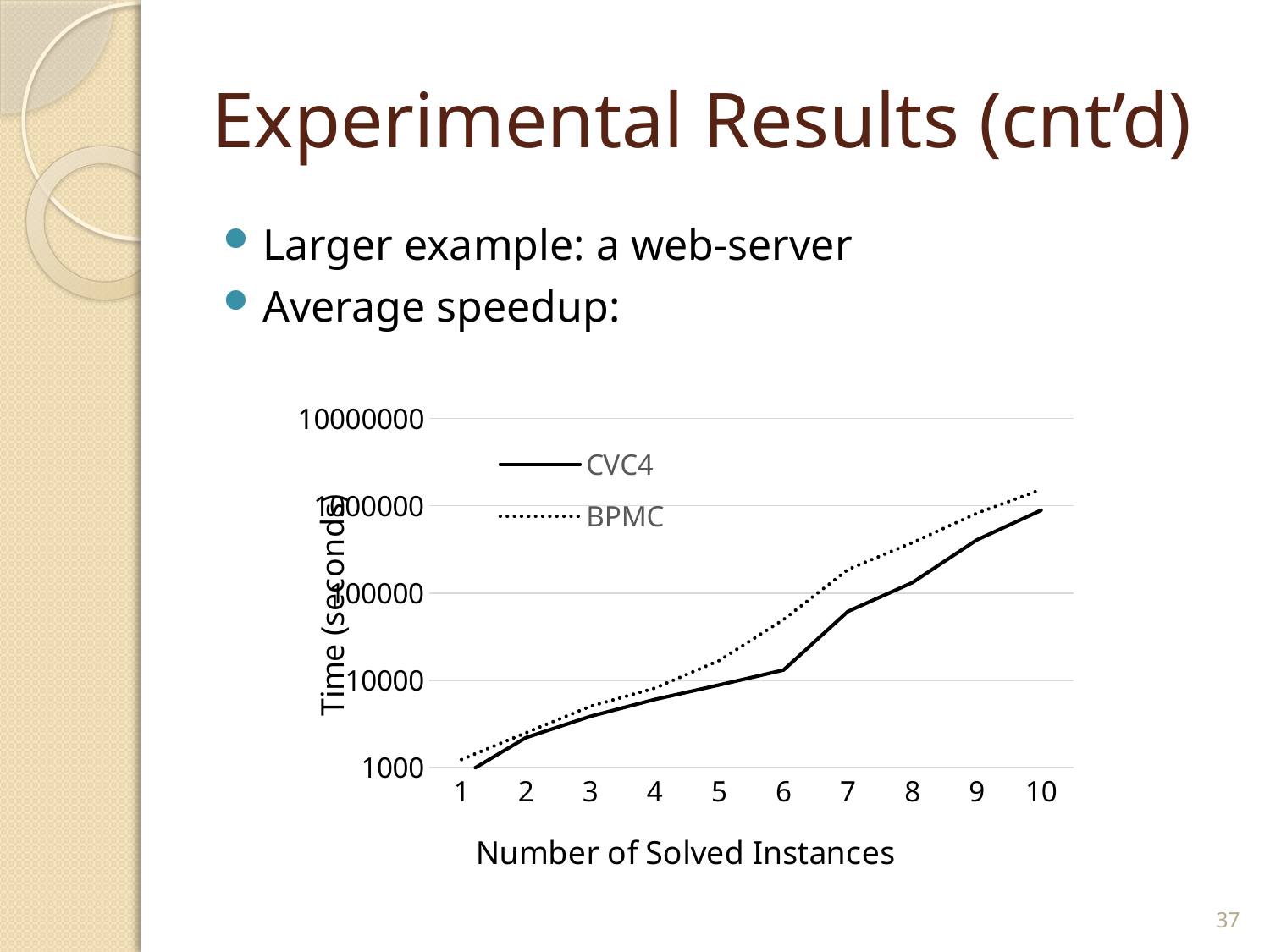
Is the CVC4 value at 6 solved instances greater or less than 10000? greater Which series is drawn with a dotted line? BPMC Is the BPMC value at 10 solved instances greater or less than 1000000? greater What kind of chart is shown on the slide? line chart How many series does the chart legend list? 2 How many points along the x axis (Number of Solved Instances) does the chart plot? 10 Do the CVC4 values rise or fall as the number of solved instances increases? rise Is the BPMC value at 7 solved instances greater or less than 100000? greater What is the label of the y axis? Time (seconds) At 10 solved instances, which series has the larger time, CVC4 or BPMC? BPMC